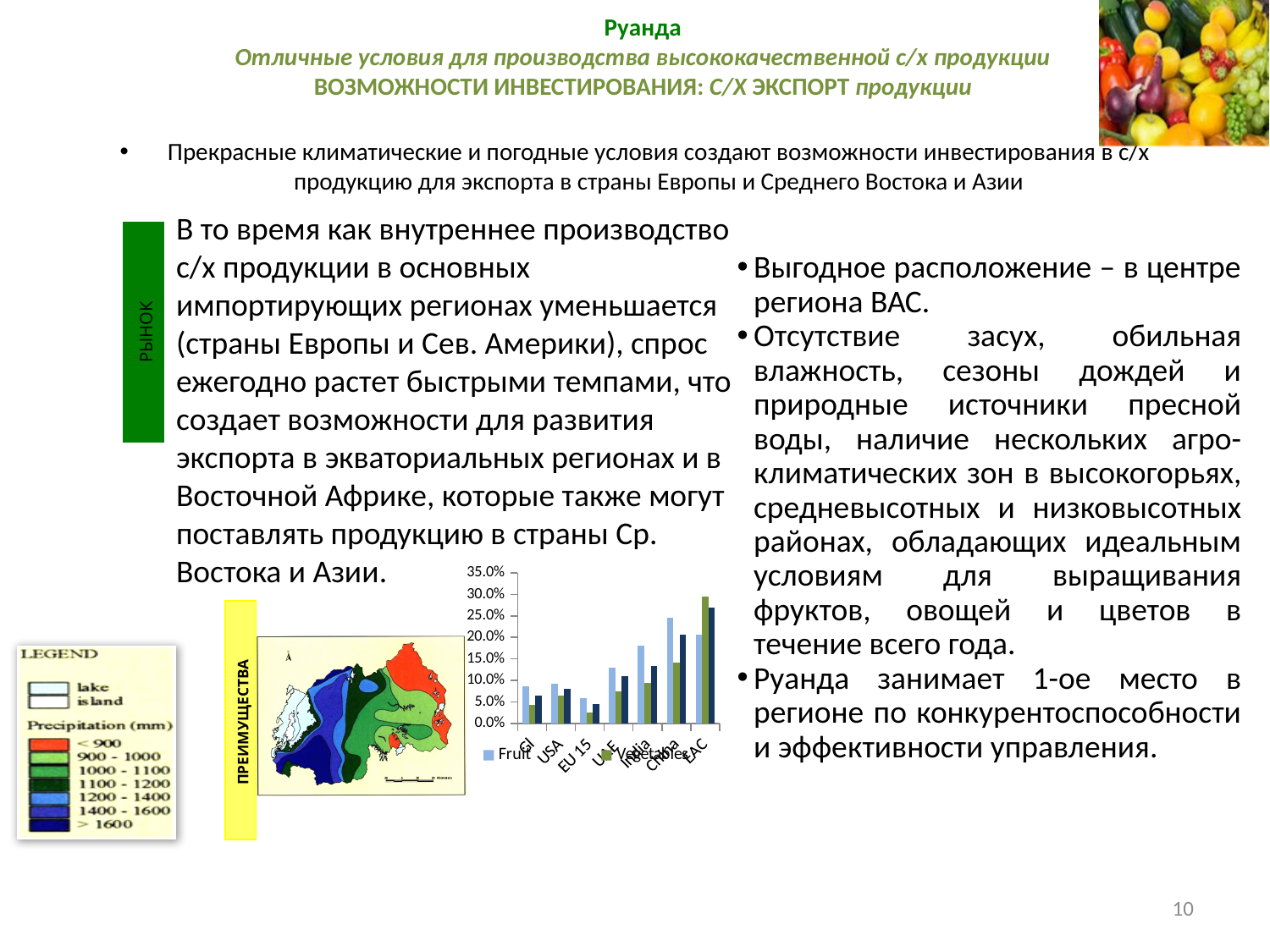
What kind of chart is shown at the bottom centre of the slide? bar chart Which category in the bar chart has the shortest bars overall? EU 15 In the bar chart, which has the larger Fruit value, China or India? China In the bar chart, which has the larger Fruit value, EAC or USA? EAC How many categories are shown on the x axis of the bar chart? 7 What is the first series named in the legend of the bar chart? Fruit Which category in the bar chart has the tallest bars overall? EAC In the bar chart, is the Fruit value for India greater or less than 10.0%? greater What is the highest value shown on the y axis of the bar chart? 35.0% In the bar chart, is the Fruit value for EAC greater or less than 15.0%? greater In the bar chart, is the Fruit value for USA greater or less than 15.0%? less